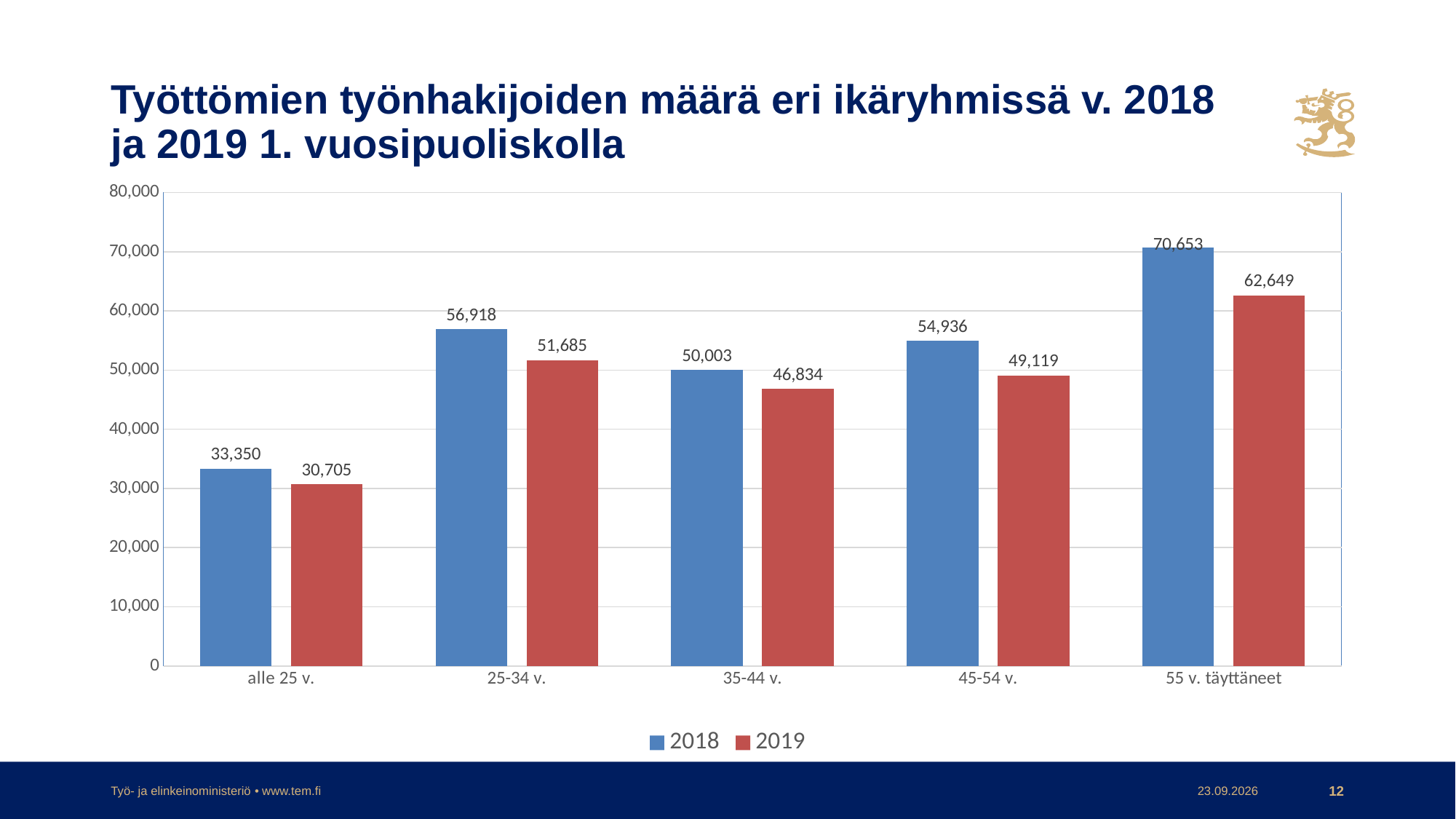
What is the value for 2019 in the alle 25 v. age group? 30,705 Is the 2019 value for 35-44 v. greater or less than 50,000? less What is the difference between the 2018 and 2019 values for the 55 v. täyttäneet age group? 8,004 Which is larger: the 2018 value for 35-44 v. or the 2018 value for 45-54 v.? 45-54 v. What kind of chart is shown on the slide? bar chart What is the difference between the 2018 and 2019 values for the 45-54 v. age group? 5,817 How many series does the legend list? 2 What is the value for 2018 in the 25-34 v. age group? 56,918 Which age group has the lowest value for 2019? alle 25 v. Which age group has the highest value for 2018? 55 v. täyttäneet How many age groups are shown on the x axis? 5 What is the value for 2019 in the 55 v. täyttäneet age group? 62,649